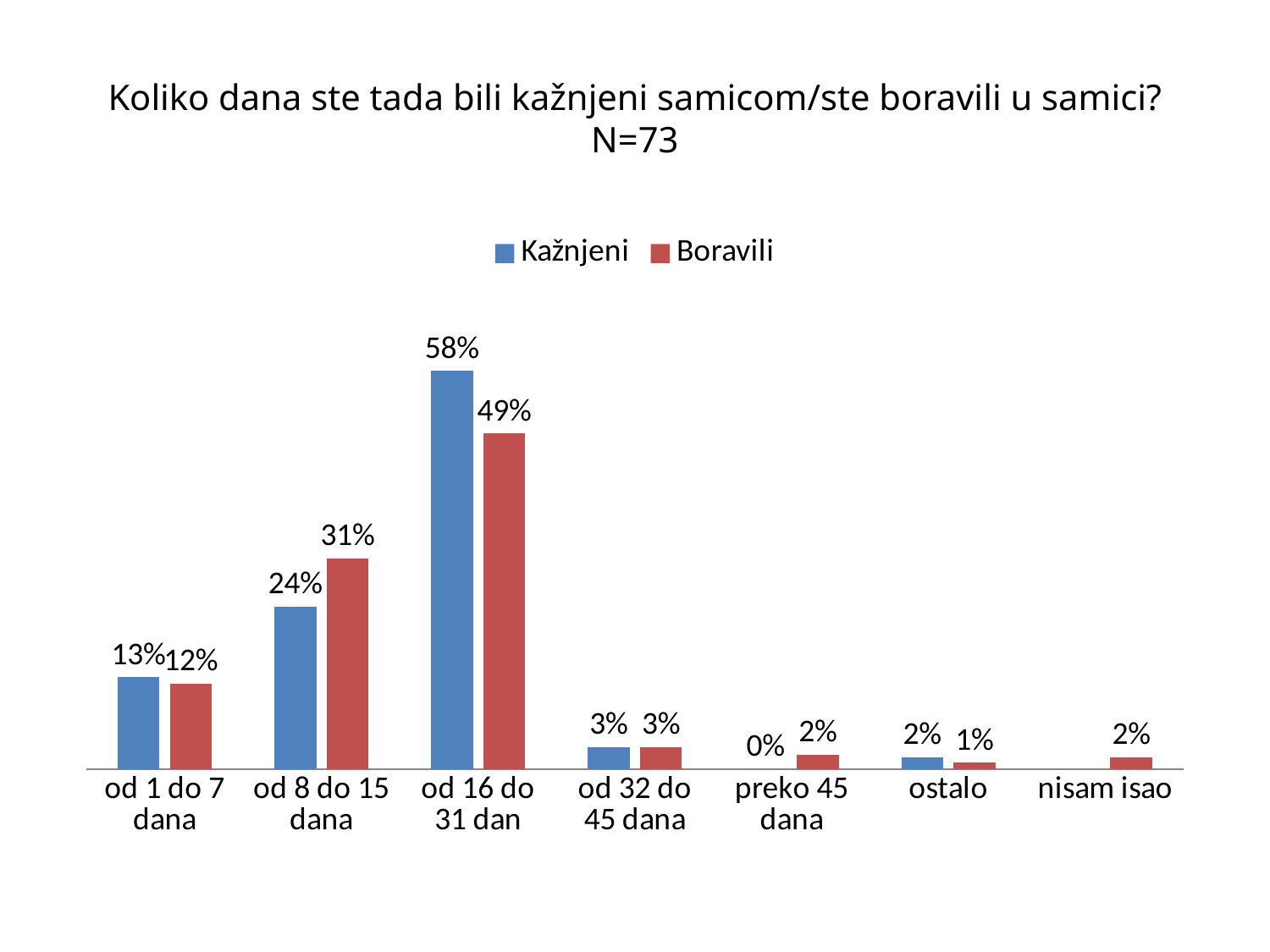
What is the value for Kažnjeni in the 'preko 45 dana' category? 0% How many categories are shown on the x axis? 7 What is the value for Boravili in the 'od 8 do 15 dana' category? 31% What is the difference between the Kažnjeni and Boravili values in the 'od 16 do 31 dan' category? 9% Which category has the highest value for the Boravili series? od 16 do 31 dan What kind of chart is shown on the slide? Bar chart How many series does the legend list? 2 In the 'od 8 do 15 dana' category, which series has the larger value, Kažnjeni or Boravili? Boravili Which category has the lowest value for the Kažnjeni series? preko 45 dana What is the value for Boravili in the 'nisam isao' category? 2% What is the sample size (N) stated in the chart title? N=73 What is the value for Kažnjeni in the 'od 16 do 31 dan' category? 58%